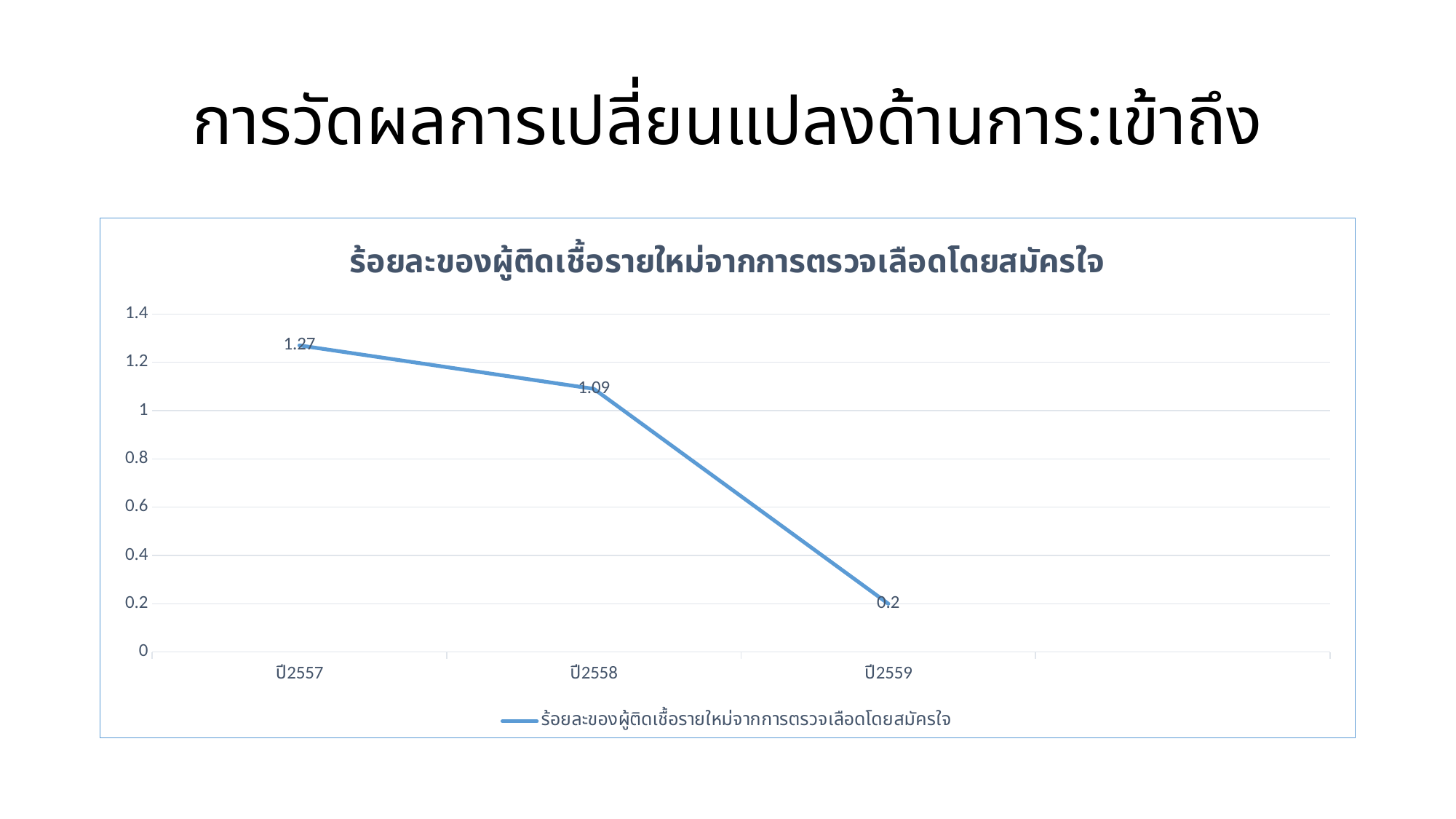
What is the value for ปี2559? 0.2 Which is larger, the value for ปี2558 or the value for ปี2559? ปี2558 How many years are plotted on the chart? 3 Is the value for ปี2558 greater or less than 1? greater What is the difference between the values for ปี2557 and ปี2558? 0.18 Do the values rise or fall from ปี2557 to ปี2559? fall Which year has the lowest value? ปี2559 What is the value for ปี2557? 1.27 What is the value for ปี2558? 1.09 Which year has the highest value? ปี2557 What is the difference between the values for ปี2557 and ปี2559? 1.07 What kind of chart is shown on the slide? line chart